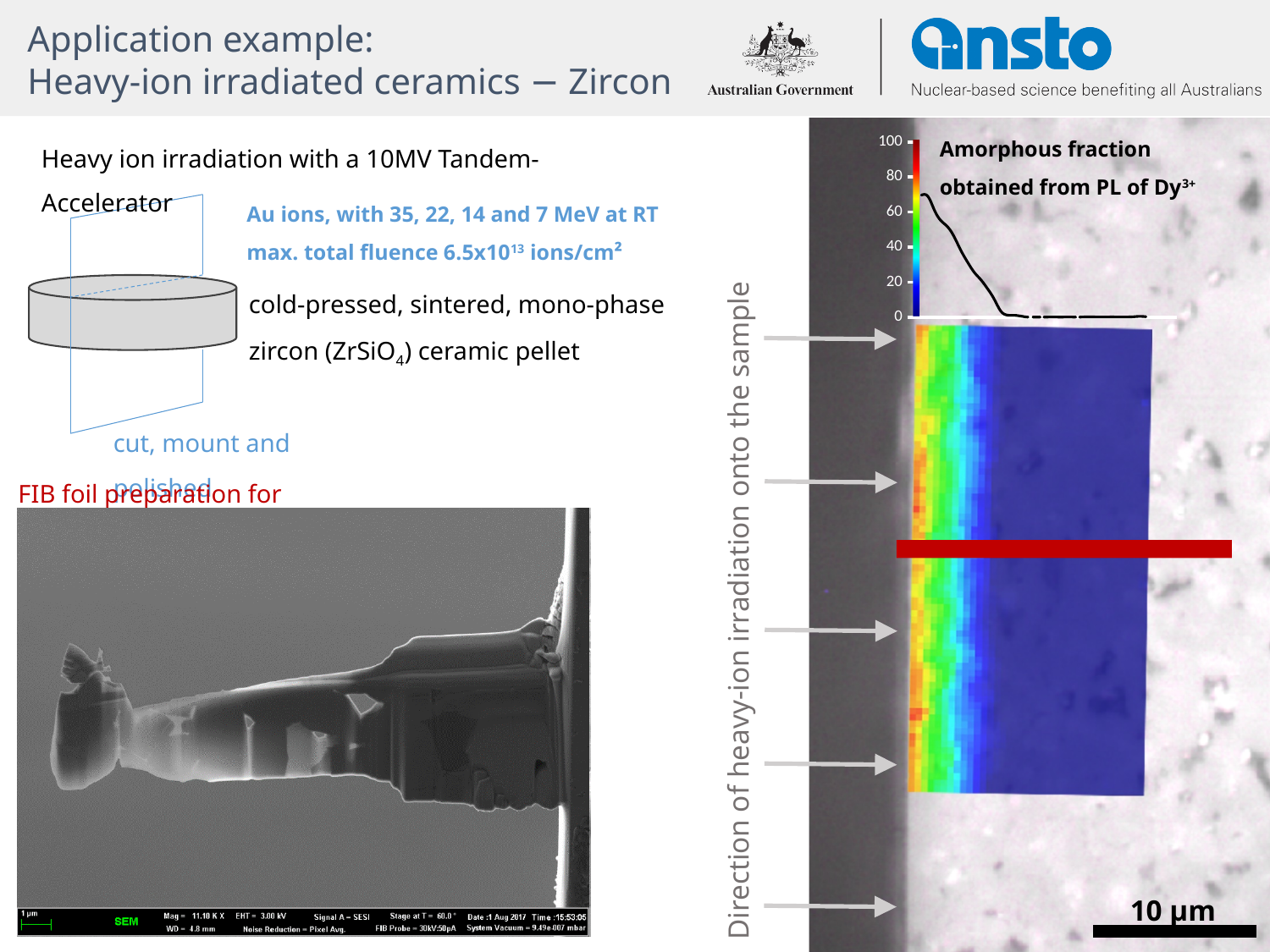
In the 'Amorphous fraction' chart, is the value at the left end of the line greater or less than 80? less What kind of chart is the 'Amorphous fraction' plot on the right of the slide? line chart What is the highest value shown on the y axis of the 'Amorphous fraction' chart? 100 What is the title of the chart on the right of the slide? Amorphous fraction obtained from PL of Dy3+ In the 'Amorphous fraction' chart, is the value at the right end of the line greater or less than 20? less In the 'Amorphous fraction' chart, is the value at the right end of the line greater or less than 40? less In the 'Amorphous fraction' chart, do the values rise or fall from left to right? fall